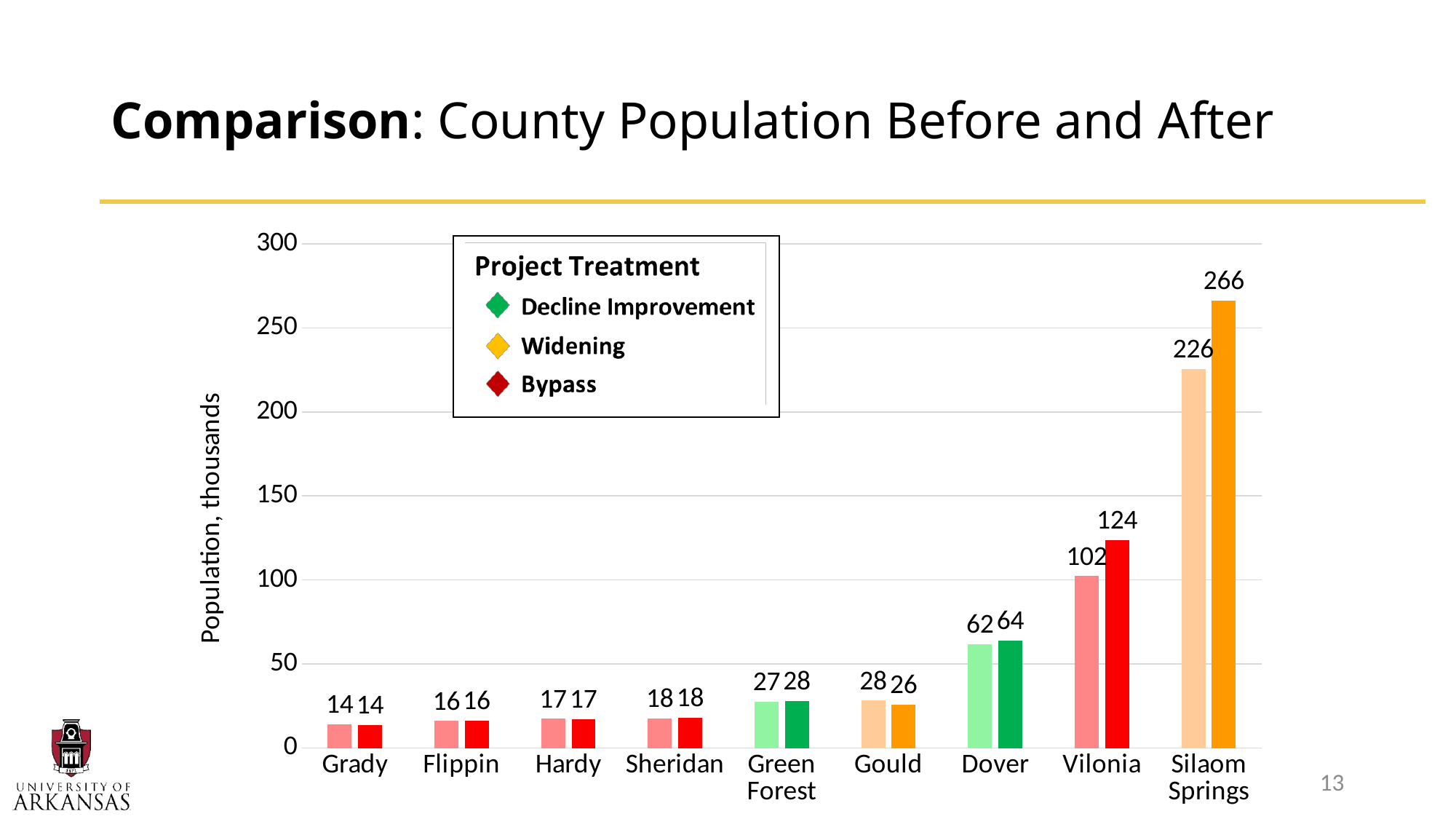
What is the 'after' population value (second bar) for Gould? 26 How many counties are shown on the x axis of the chart? 9 Is the 'before' value for Siloam Springs greater or less than 200? greater What is the difference between the 'after' and 'before' values for Siloam Springs? 40 What is the difference between the 'after' and 'before' values for Vilonia? 22 Which county has the highest population value on the chart? Silaom Springs Which is larger, the 'after' value for Dover or the 'after' value for Vilonia? Vilonia What kind of chart is shown on the slide? Bar chart What is the 'before' population value (first bar) for Vilonia? 102 What is the 'after' population value (second bar) for Siloam Springs? 266 Which county has the lowest population values on the chart? Grady How many project treatments does the legend list? 3